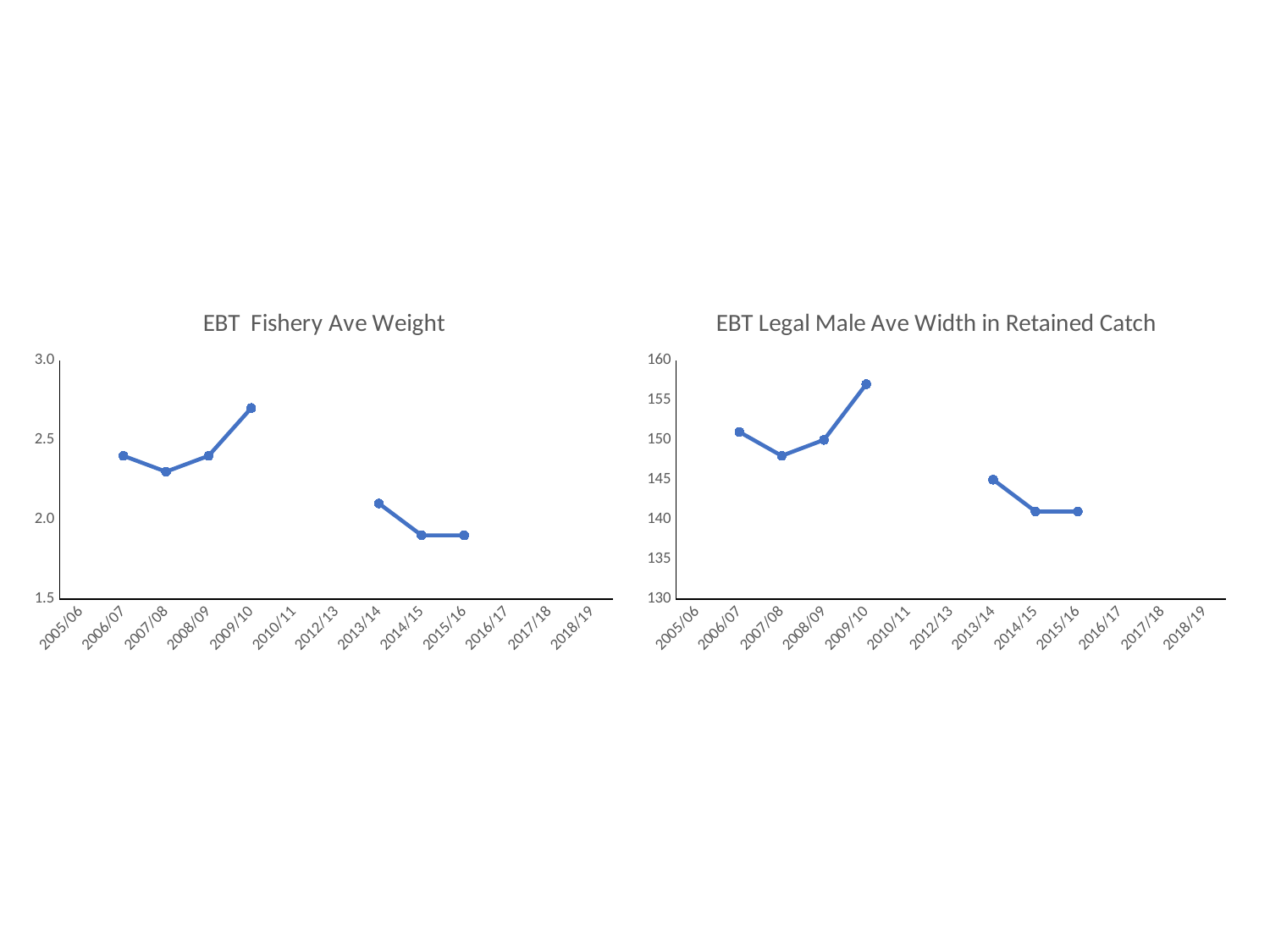
In the "EBT Fishery Ave Weight" chart, is the value for 2009/10 greater or less than 2.5? greater In the "EBT Legal Male Ave Width in Retained Catch" chart, is the value for 2009/10 greater or less than 155? greater In the "EBT Fishery Ave Weight" chart, which season has the highest value? 2009/10 In the "EBT Fishery Ave Weight" chart, is the value for 2014/15 greater or less than 2.0? less In the "EBT Legal Male Ave Width in Retained Catch" chart, which season has the highest value? 2009/10 In the "EBT Fishery Ave Weight" chart, which is larger, the value for 2007/08 or the value for 2013/14? 2007/08 In the "EBT Legal Male Ave Width in Retained Catch" chart, which is larger, the value for 2006/07 or the value for 2013/14? 2006/07 What kind of chart is the "EBT Fishery Ave Weight" chart? line chart What is the title of the chart on the right side of the slide? EBT Legal Male Ave Width in Retained Catch How many data points are plotted in the "EBT Fishery Ave Weight" chart? 7 In the "EBT Legal Male Ave Width in Retained Catch" chart, do the values rise or fall from 2013/14 to 2014/15? fall